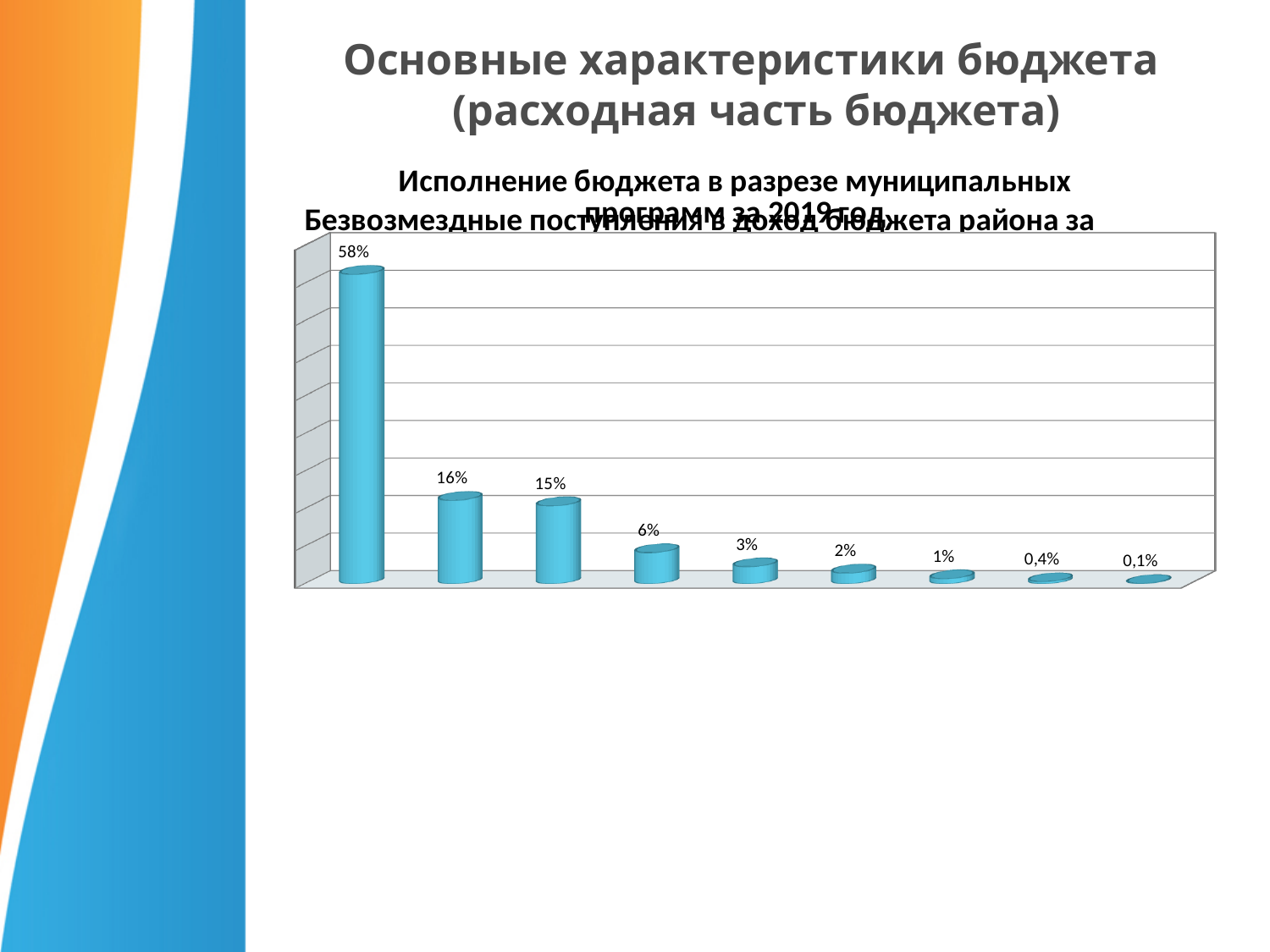
What is the highest value labelled on any bar in the chart? 58% Do the bar values rise or fall from left to right across the chart? fall What is the value shown on the last (rightmost) bar? 0,1% What is the lowest value labelled on any bar in the chart? 0,1% What is the value shown on the fourth bar from the left? 6% What is the value shown on the first (leftmost) bar? 58% What is the difference between the first bar (58%) and the second bar (16%)? 42% How many bars are plotted in the chart? 9 What is the value shown on the second bar from the left? 16% What is the value shown on the third bar from the left? 15% Which is larger: the value of the second bar or the value of the third bar? the second bar (16%) What type of chart is shown on the slide? bar chart